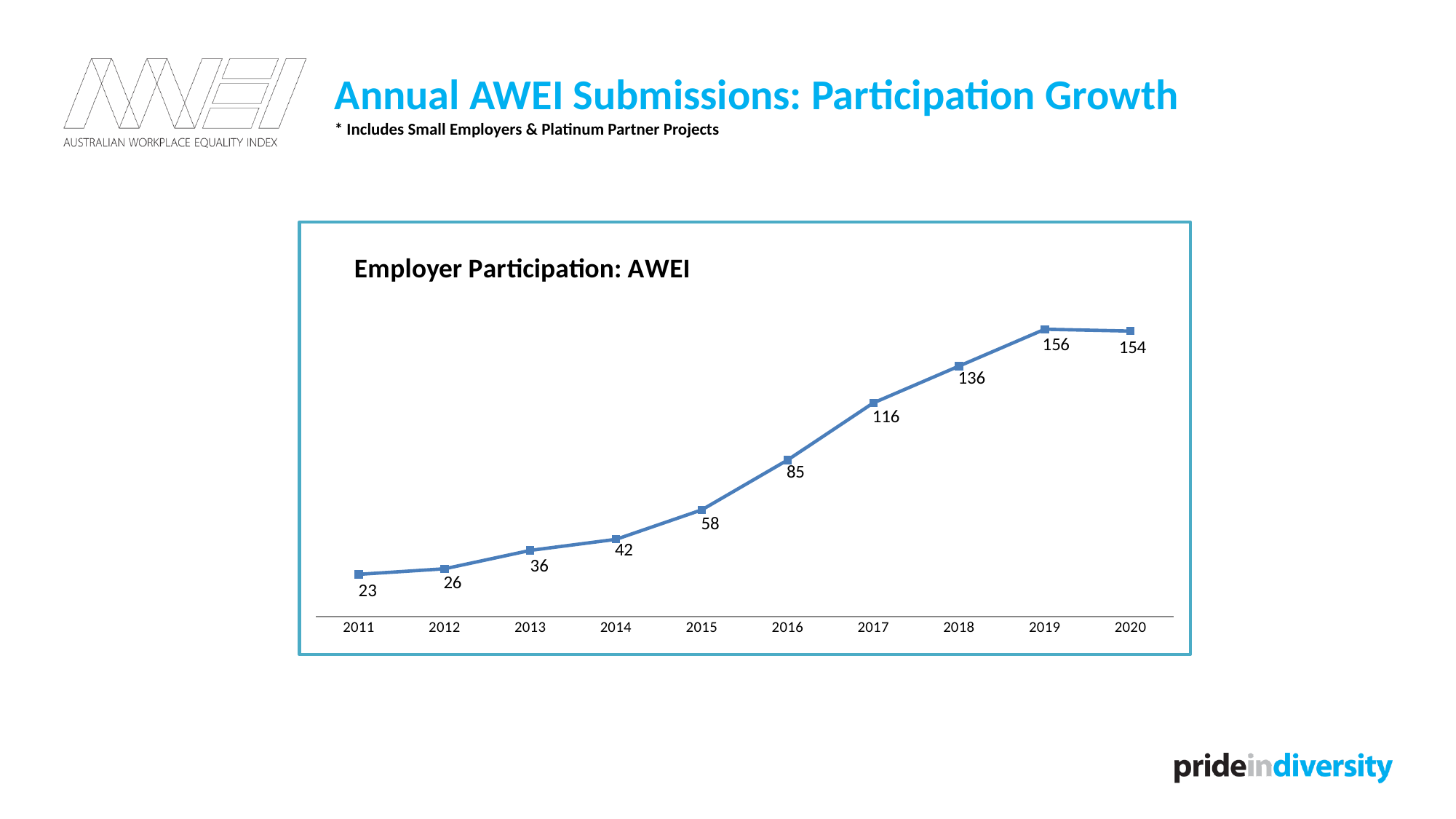
What kind of chart is shown on the slide? Line chart Which year has the highest employer participation? 2019 Which is larger, the value for 2016 or the value for 2014? 2016 What is the employer participation value for 2015? 58 What is the title of the chart? Employer Participation: AWEI What is the difference between the 2018 and 2017 values? 20 How many years are plotted on the chart? 10 What is the employer participation value for 2020? 154 Do the values generally rise or fall from 2011 to 2019? Rise What is the employer participation value for 2011? 23 Which year has the lowest employer participation? 2011 What is the difference between the 2019 and 2011 values? 133